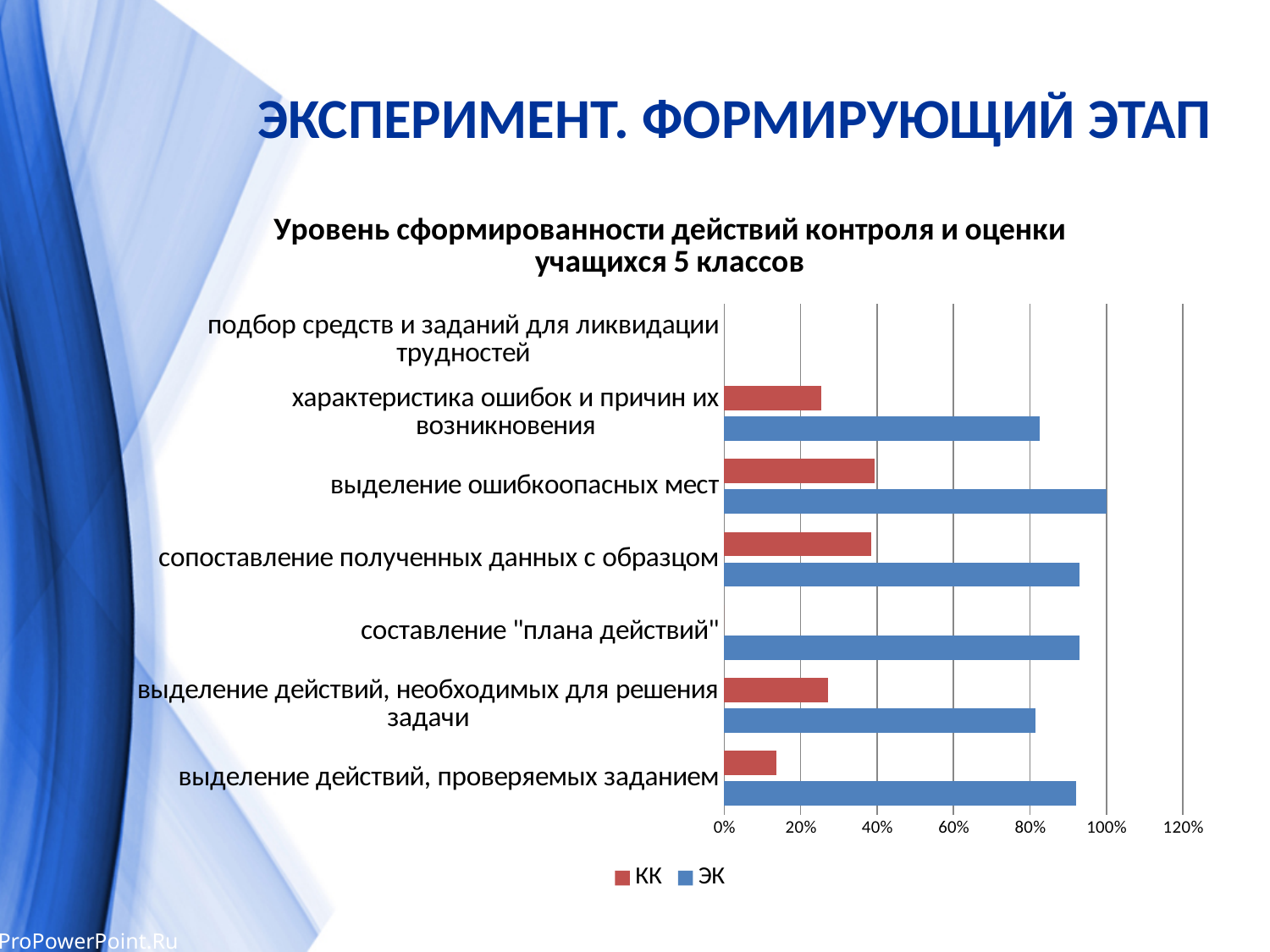
For "выделение действий, необходимых для решения задачи", which series has the larger value, КК or ЭК? ЭК Is the КК value for "выделение действий, проверяемых заданием" greater or less than 20%? less How many series does the legend list? 2 How many categories are shown on the vertical axis of the chart? 7 Which is larger: the КК value for "характеристика ошибок и причин их возникновения" or the КК value for "выделение действий, проверяемых заданием"? характеристика ошибок и причин их возникновения Is the КК value for "сопоставление полученных данных с образцом" greater or less than 20%? greater What kind of chart is shown on the slide? bar chart What is the title of the chart? Уровень сформированности действий контроля и оценки учащихся 5 классов Which category has the highest ЭК value? выделение ошибкоопасных мест What is the ЭК value for "выделение ошибкоопасных мест"? 100% Is the ЭК value for "характеристика ошибок и причин их возникновения" greater or less than 60%? greater Which colour represents the ЭК series in the legend? blue